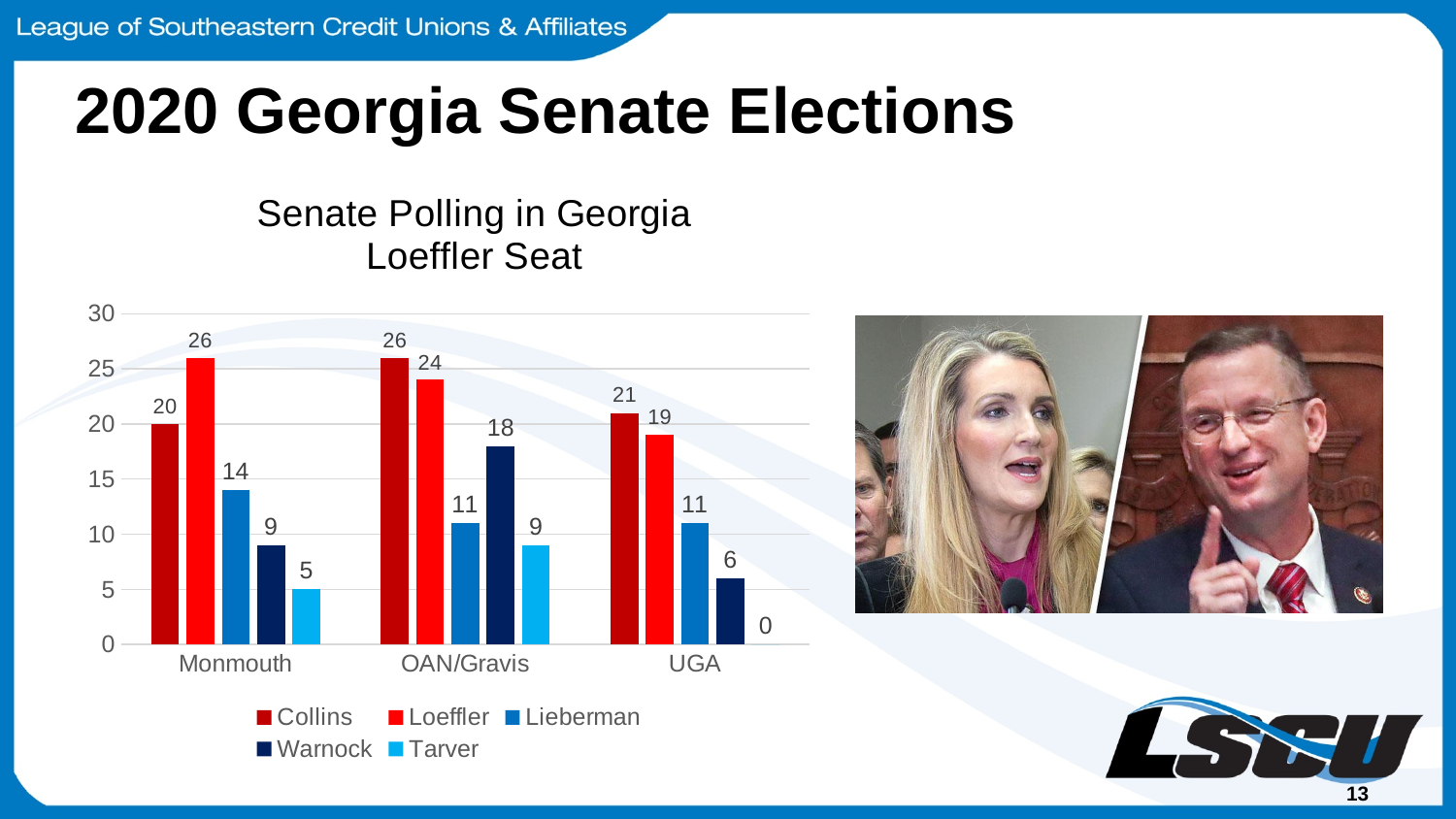
What is the title of the chart? Senate Polling in Georgia Loeffler Seat What kind of chart is shown on the slide? Bar chart Which candidate has the lowest value in the UGA poll? Tarver What is the difference between Collins and Loeffler in the OAN/Gravis poll? 2 In the UGA poll, which is larger, the value for Collins or the value for Loeffler? Collins How many polls (categories) are shown on the x axis? 3 What is the value for Loeffler in the Monmouth poll? 26 What is the difference between Lieberman and Warnock in the Monmouth poll? 5 What is the value for Warnock in the OAN/Gravis poll? 18 Which candidate has the highest value in the Monmouth poll? Loeffler How many series does the legend list? 5 What is the value for Tarver in the UGA poll? 0